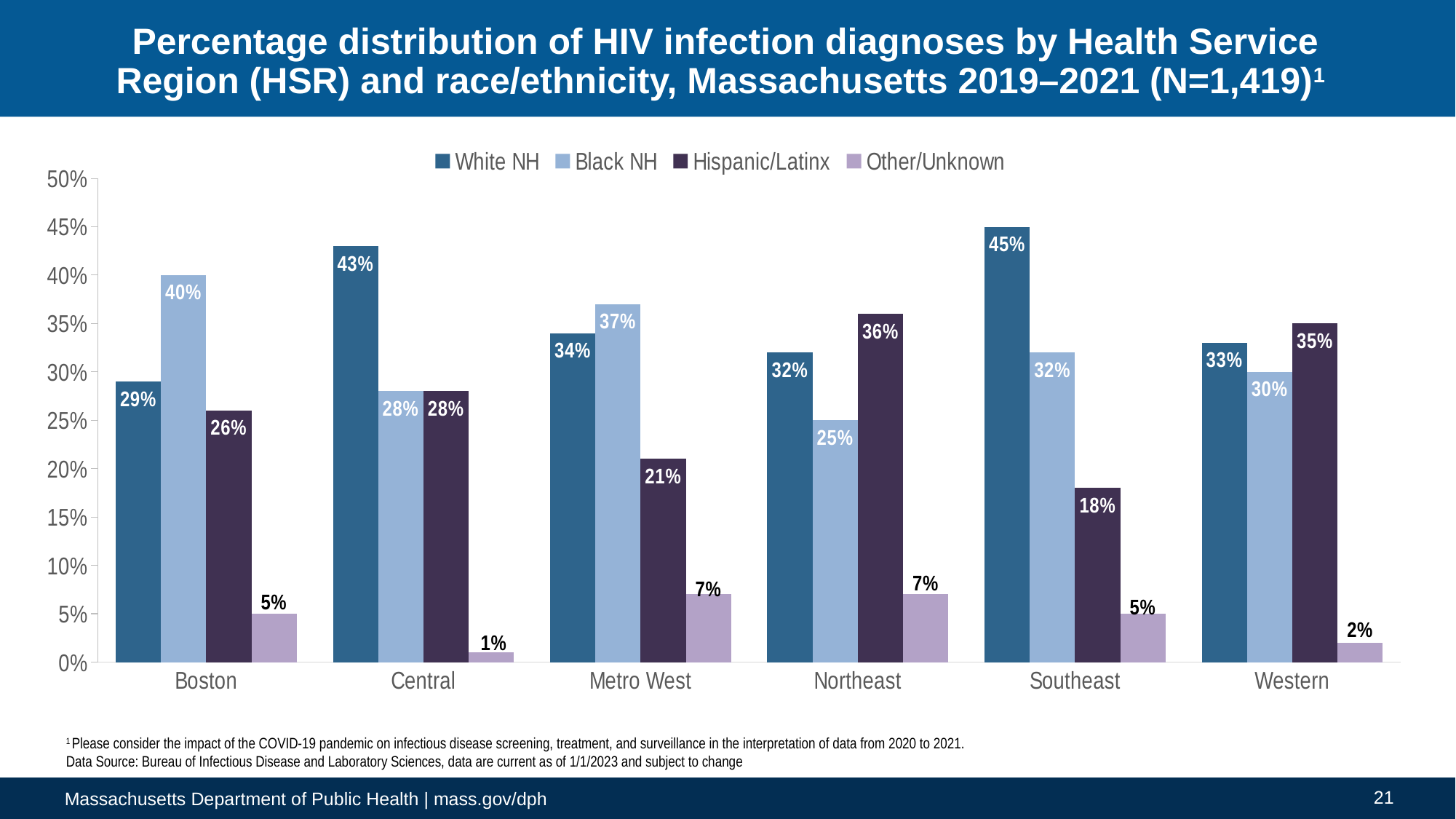
Which region has the lowest value for Hispanic/Latinx? Southeast Which series is shown in the lightest purple colour in the legend? Other/Unknown What is the value for Black NH in Boston? 40% What kind of chart is shown on the slide? Bar chart Which region has the highest value for White NH? Southeast Which is larger in Western: the White NH value or the Hispanic/Latinx value? Hispanic/Latinx What is the value for White NH in Southeast? 45% What is the difference between the White NH and Black NH values in Central? 15% What is the value for Hispanic/Latinx in Northeast? 36% What is the value for Other/Unknown in Central? 1% How many regions are shown on the x axis? 6 How many series does the legend list? 4